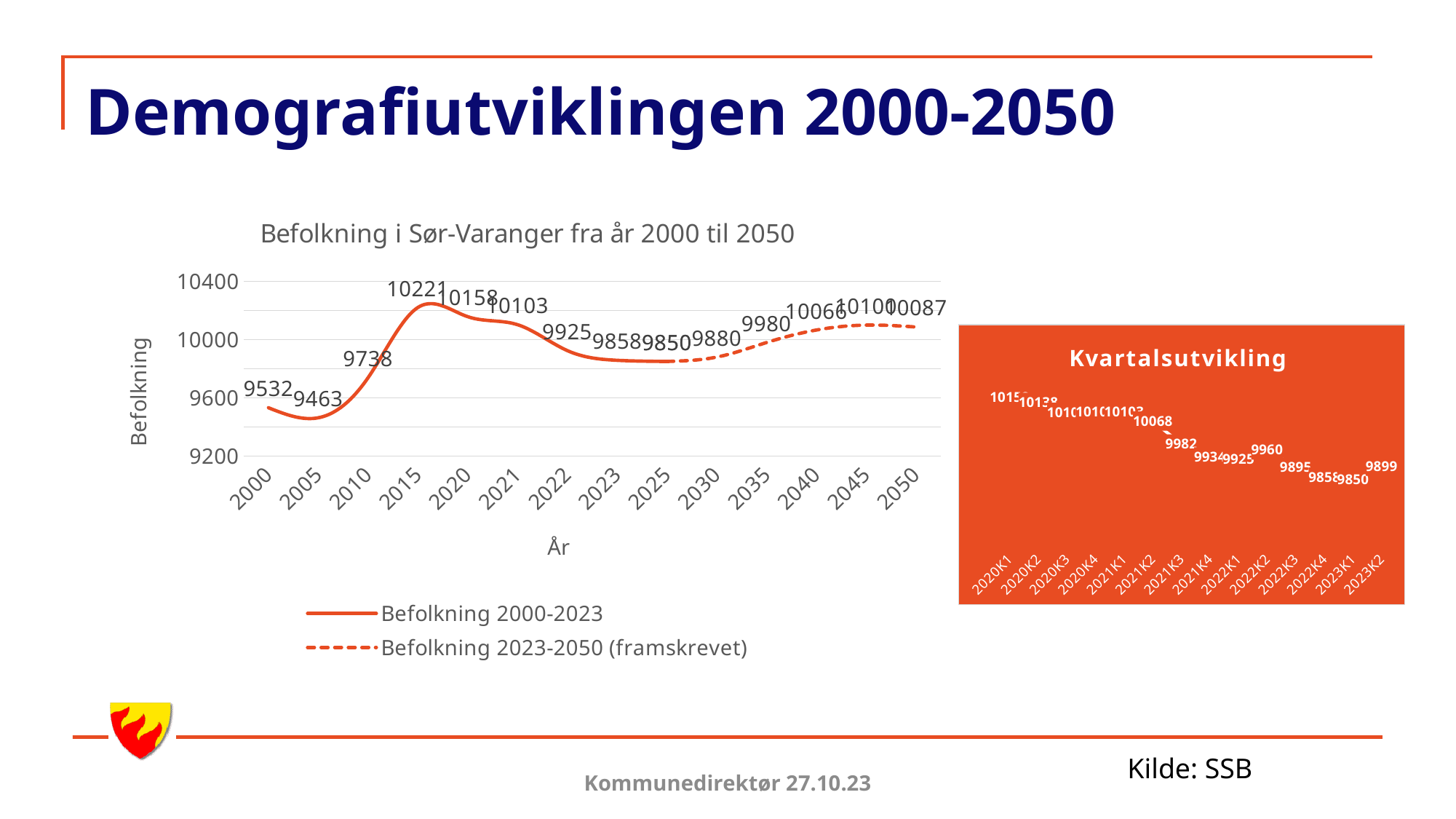
In the chart 'Befolkning i Sør-Varanger fra år 2000 til 2050', what is the population value for 2000? 9532 What kind of chart is 'Befolkning i Sør-Varanger fra år 2000 til 2050'? Line chart In the chart 'Befolkning i Sør-Varanger fra år 2000 til 2050', does the population rise or fall from 2015 to 2023? Fall In the chart 'Befolkning i Sør-Varanger fra år 2000 til 2050', what is the population value for 2015? 10221 In the chart 'Befolkning i Sør-Varanger fra år 2000 til 2050', which is larger, the value for 2020 or the value for 2022? 2020 In the chart 'Befolkning i Sør-Varanger fra år 2000 til 2050', which year has the highest population value? 2015 How many quarter labels are on the x axis of the 'Kvartalsutvikling' chart on the right? 14 In the chart 'Befolkning i Sør-Varanger fra år 2000 til 2050', what is the difference between the values for 2015 and 2005? 758 How many series does the legend of the chart 'Befolkning i Sør-Varanger fra år 2000 til 2050' list? 2 In the chart 'Befolkning i Sør-Varanger fra år 2000 til 2050', which year has the lowest population value? 2005 In the chart 'Befolkning i Sør-Varanger fra år 2000 til 2050', which legend entry is drawn with a dashed line? Befolkning 2023-2050 (framskrevet) How many year labels are on the x axis of the chart 'Befolkning i Sør-Varanger fra år 2000 til 2050'? 14